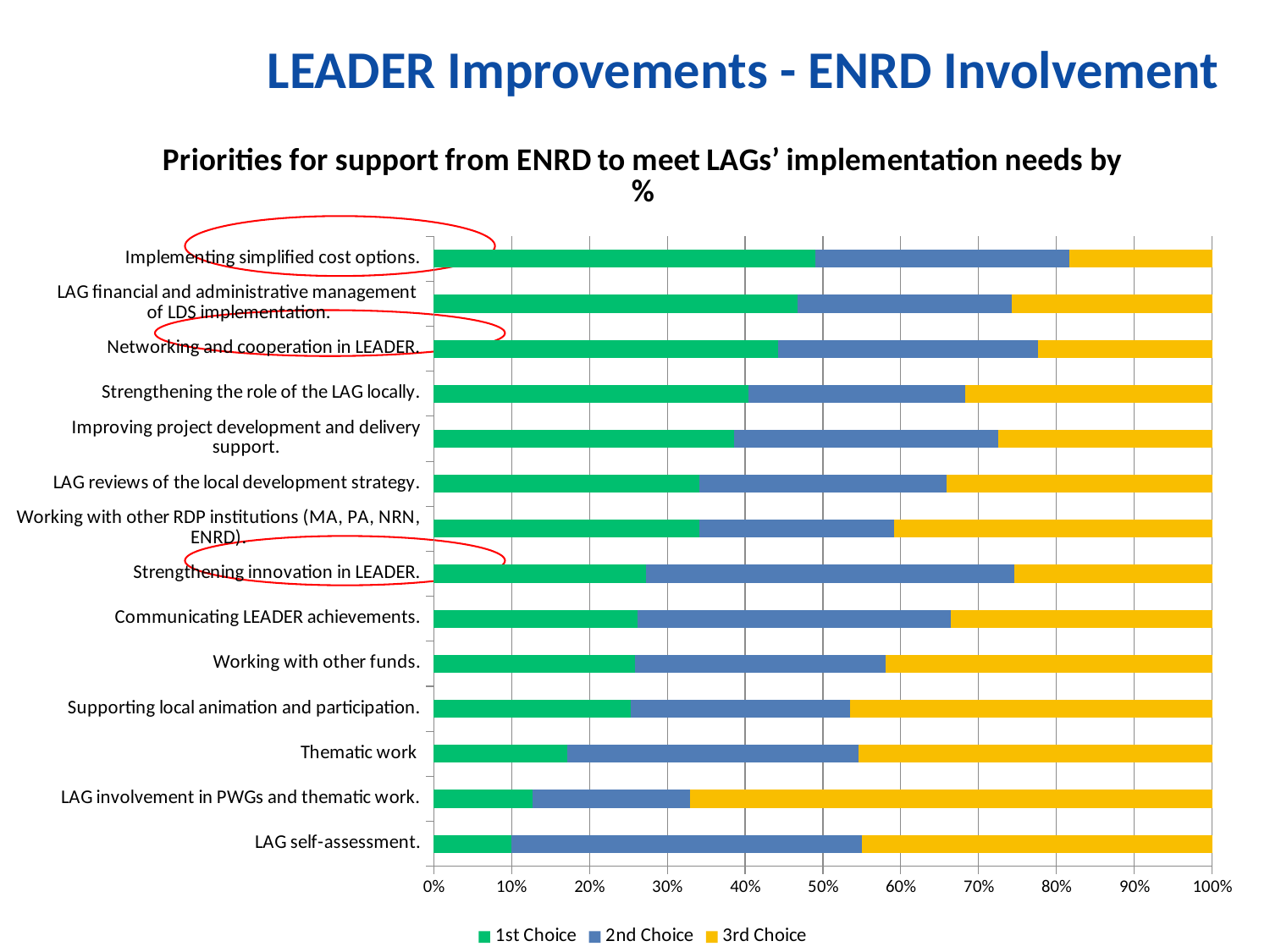
Is the 1st Choice value for Thematic work greater or less than 20%? less What kind of chart is shown on the slide? Stacked bar chart Which category has the lowest 1st Choice share? LAG self-assessment. How many categories (priorities) are listed on the vertical axis of the chart? 14 Which has the larger 3rd Choice share: LAG involvement in PWGs and thematic work or Implementing simplified cost options? LAG involvement in PWGs and thematic work. Is the 1st Choice value for Working with other funds greater or less than 20%? greater Which has the larger 1st Choice share: Networking and cooperation in LEADER or Communicating LEADER achievements? Networking and cooperation in LEADER. How many series does the chart legend list? 3 Is the 1st Choice value for Implementing simplified cost options greater or less than 40%? greater What is the title of the chart? Priorities for support from ENRD to meet LAGs' implementation needs by % What are the three series named in the chart legend? 1st Choice, 2nd Choice, 3rd Choice Which category has the highest 1st Choice share? Implementing simplified cost options.